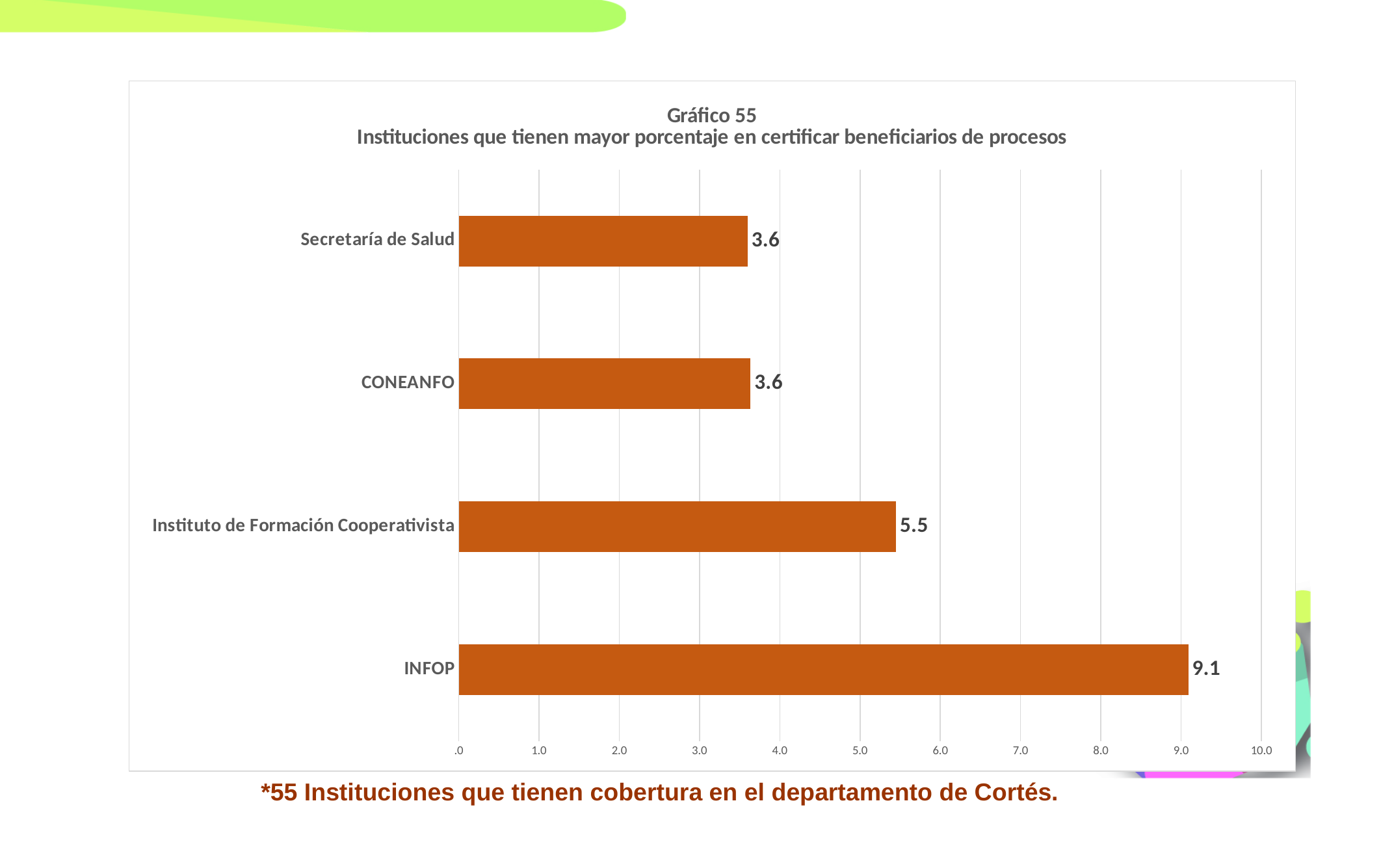
What is the value for Instituto de Formación Cooperativista? 5.5 What is the difference between the values for Instituto de Formación Cooperativista and CONEANFO? 1.9 Which is larger, the value for INFOP or the value for Instituto de Formación Cooperativista? INFOP What is the value for CONEANFO? 3.6 What is the value for Secretaría de Salud? 3.6 What is the value for INFOP? 9.1 Which institution has the highest value? INFOP Is the value for INFOP greater or less than 8.0? greater What kind of chart is shown on the slide? bar chart What is the difference between the values for INFOP and Instituto de Formación Cooperativista? 3.6 How many institutions are shown in the chart? 4 What is the number of the chart given in its title? Gráfico 55